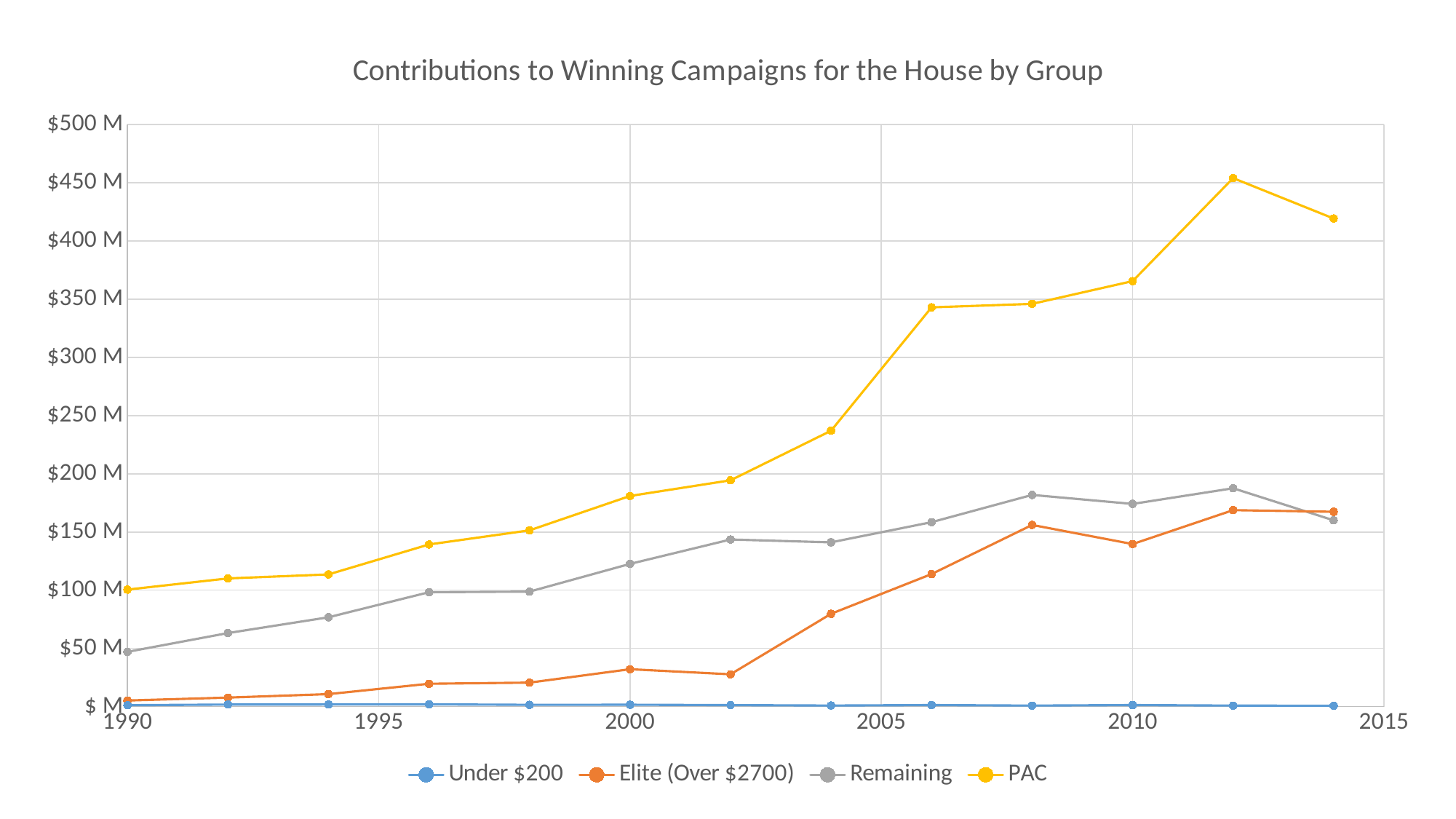
Which series is shown in yellow? PAC How many series does the legend list? 4 Which series is larger in 2004, Remaining or Elite (Over $2700)? Remaining What kind of chart is shown on the slide? line chart Which series has the highest values across the chart? PAC Does the PAC series generally rise or fall from 1990 to 2012? rise Is the Elite (Over $2700) value for 2000 greater or less than $50 M? less In which year does the PAC series reach its highest point? 2012 Is the PAC value for 2012 greater or less than $400 M? greater Is the Remaining value for 2008 greater or less than $150 M? greater Which series has the lowest values across the chart? Under $200 What is the title of the chart? Contributions to Winning Campaigns for the House by Group